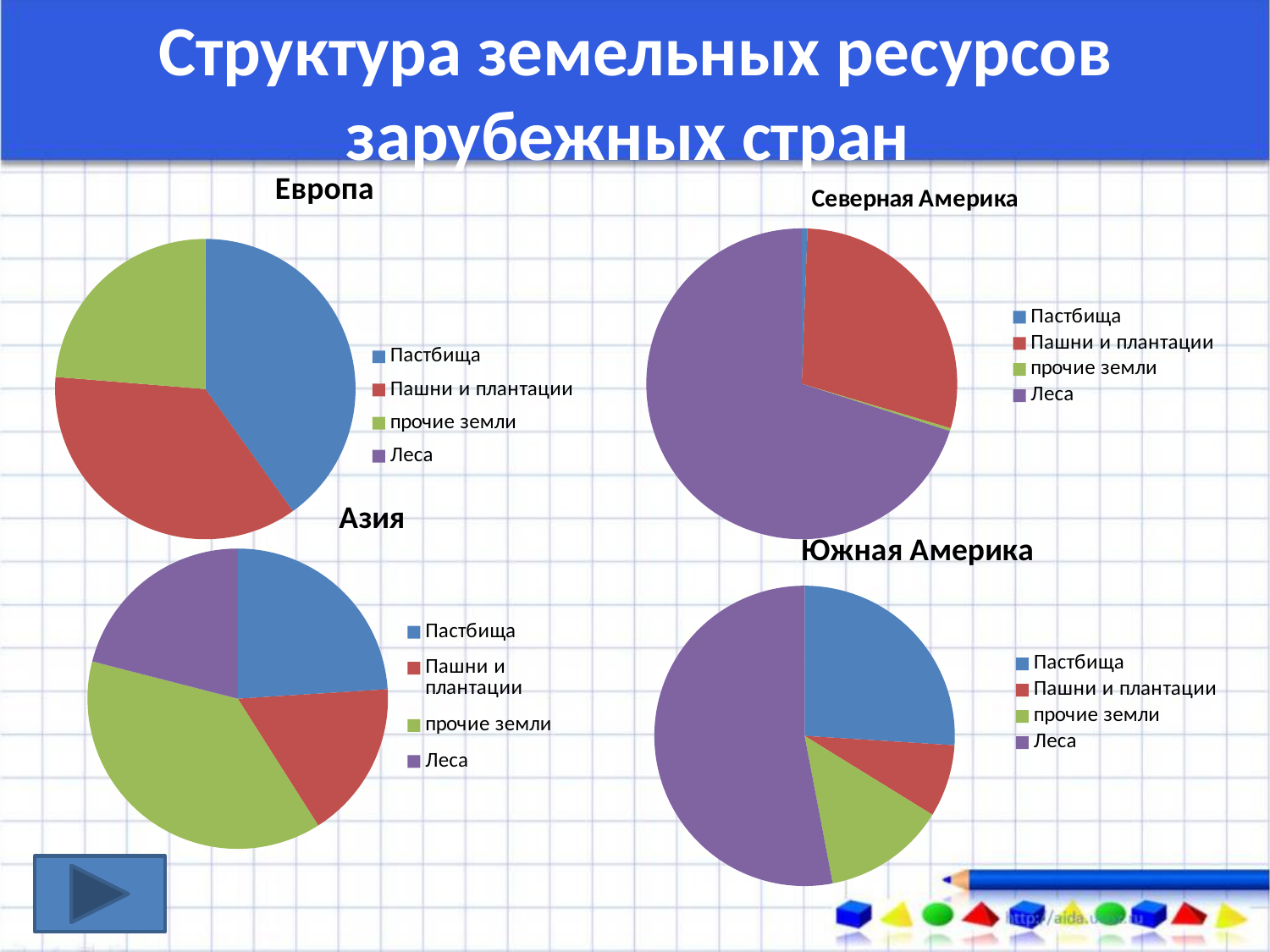
In the "Северная Америка" chart, which slice is larger: Леса or Пашни и плантации? Леса How many pie charts are shown on the slide? 4 In the "Азия" chart, which category has the largest slice? прочие земли In the "Южная Америка" chart, which category has the largest slice? Леса In the "Южная Америка" chart, which category has the smallest slice? Пашни и плантации In the "Азия" chart, which slice is larger: прочие земли or Пастбища? прочие земли How many entries does the legend of the "Азия" chart list? 4 In the "Южная Америка" chart, which slice is larger: Пастбища or Пашни и плантации? Пастбища What kind of chart is the "Европа" chart? pie chart In the "Северная Америка" chart, which category has the largest slice? Леса What colour represents Леса in the "Южная Америка" chart? purple